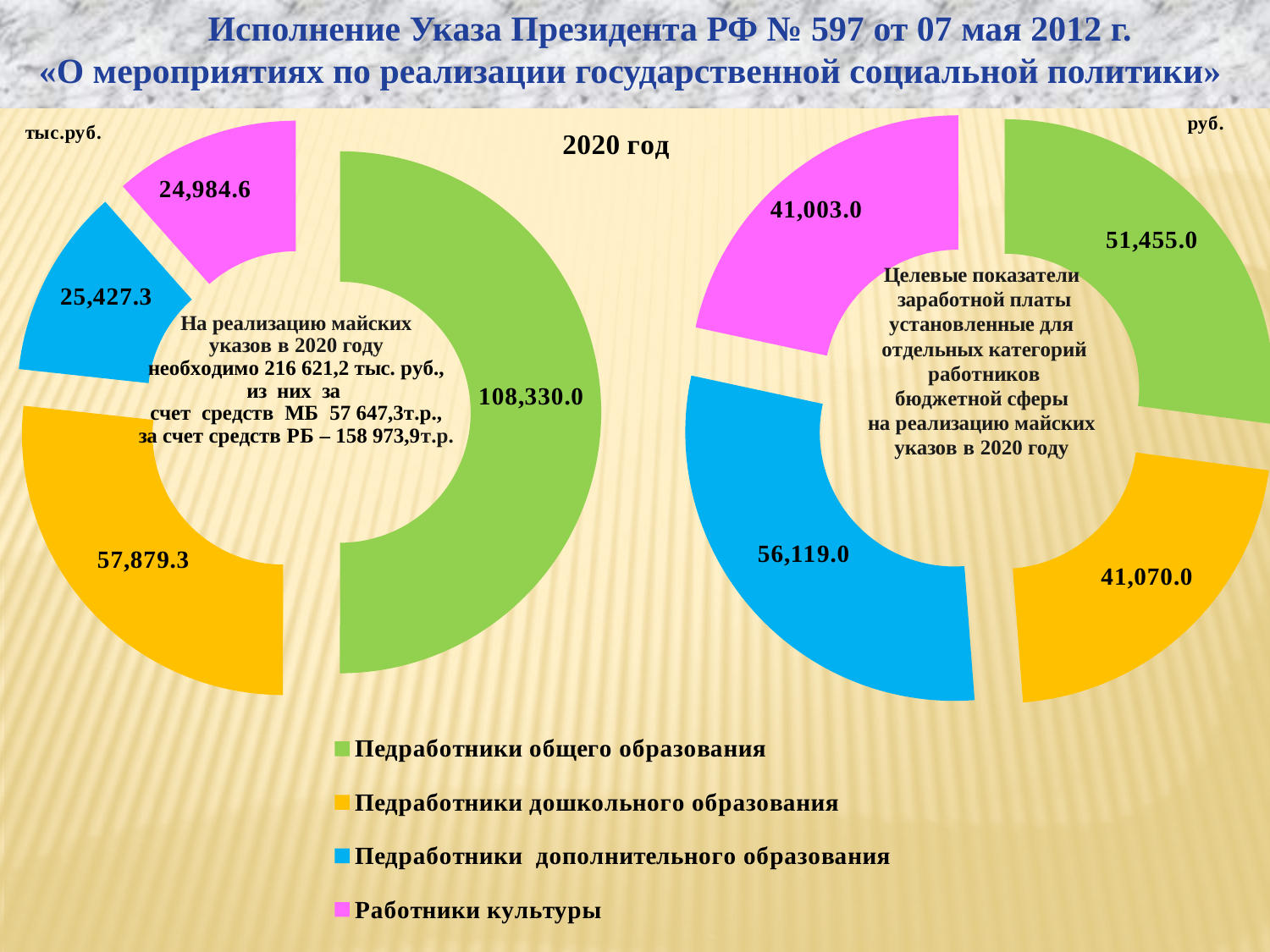
How many categories does the legend list? 4 On the left chart (тыс.руб.), what is the value for Педработники общего образования? 108,330.0 On the right chart (руб.), what is the value for Педработники дополнительного образования? 56,119.0 On the left chart (тыс.руб.), what is the value for Работники культуры? 24,984.6 On the left chart (тыс.руб.), what is the difference between Педработники общего образования and Педработники дошкольного образования? 50,450.7 On the right chart (руб.), what is the value for Педработники дошкольного образования? 41,070.0 On the right chart (руб.), what is the difference between Педработники дополнительного образования and Работники культуры? 15,116.0 On the left chart (тыс.руб.), which category has the largest value? Педработники общего образования On the right chart (руб.), which is larger: Педработники общего образования or Педработники дошкольного образования? Педработники общего образования On the left chart (тыс.руб.), which category has the smallest value? Работники культуры On the right chart (руб.), which category has the largest value? Педработники дополнительного образования What kind of chart is used on the left side of the slide? pie chart (doughnut)